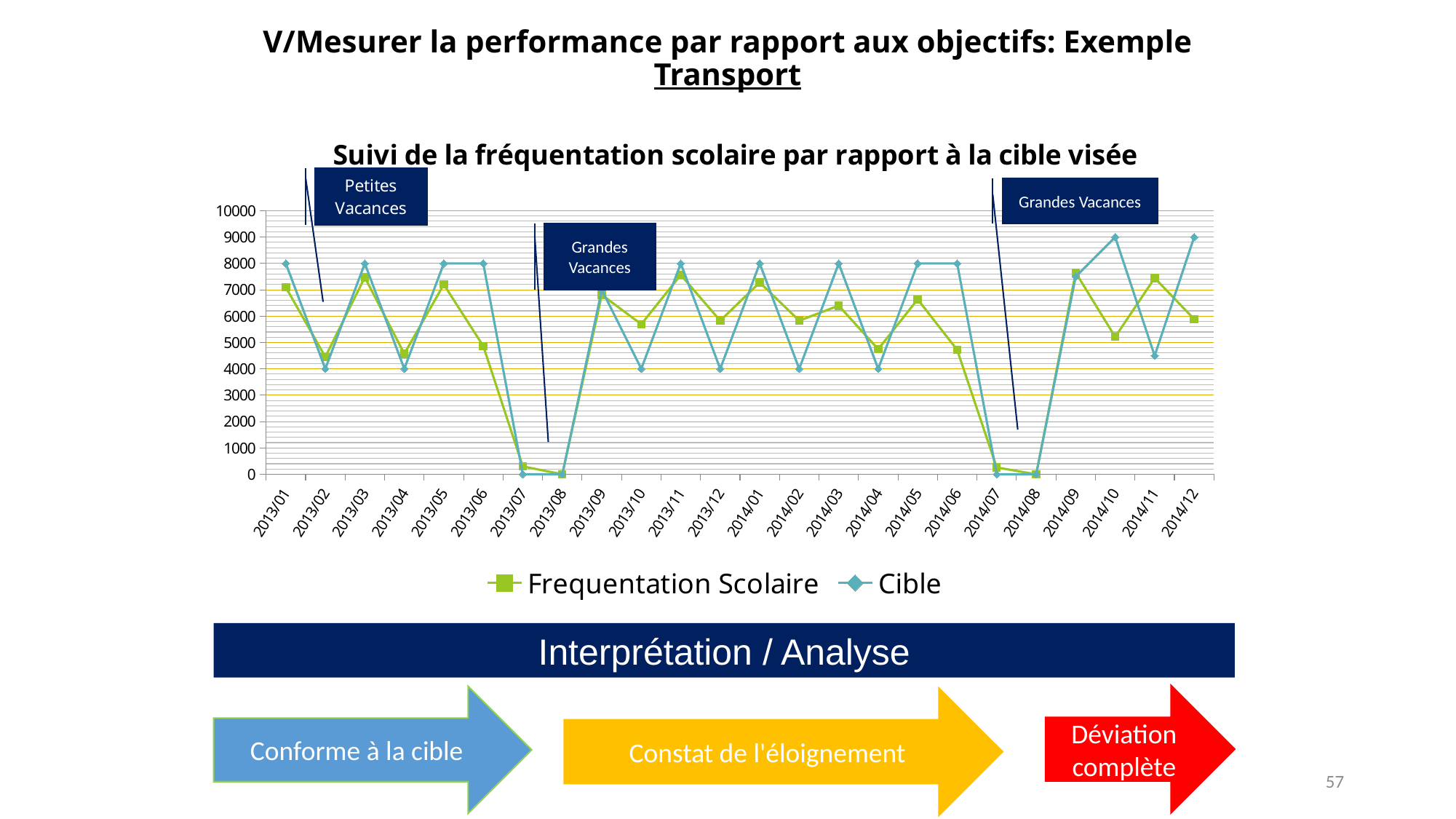
How many months are plotted along the x axis? 24 What is the Cible value for 2014/10? 9000 What is the Cible value for 2013/01? 8000 For 2014/10, which series has the larger value, Frequentation Scolaire or Cible? Cible How many series does the legend list? 2 Is the Frequentation Scolaire value for 2014/06 greater or less than 5000? less Does the Cible series rise or fall from 2014/09 to 2014/10? rise What type of chart is shown on the slide? line chart What is the Cible value for 2013/02? 4000 Is the Frequentation Scolaire value for 2014/11 greater or less than 7000? greater Is the Frequentation Scolaire value for 2013/10 greater or less than 6000? less What is the title of the chart? Suivi de la fréquentation scolaire par rapport à la cible visée